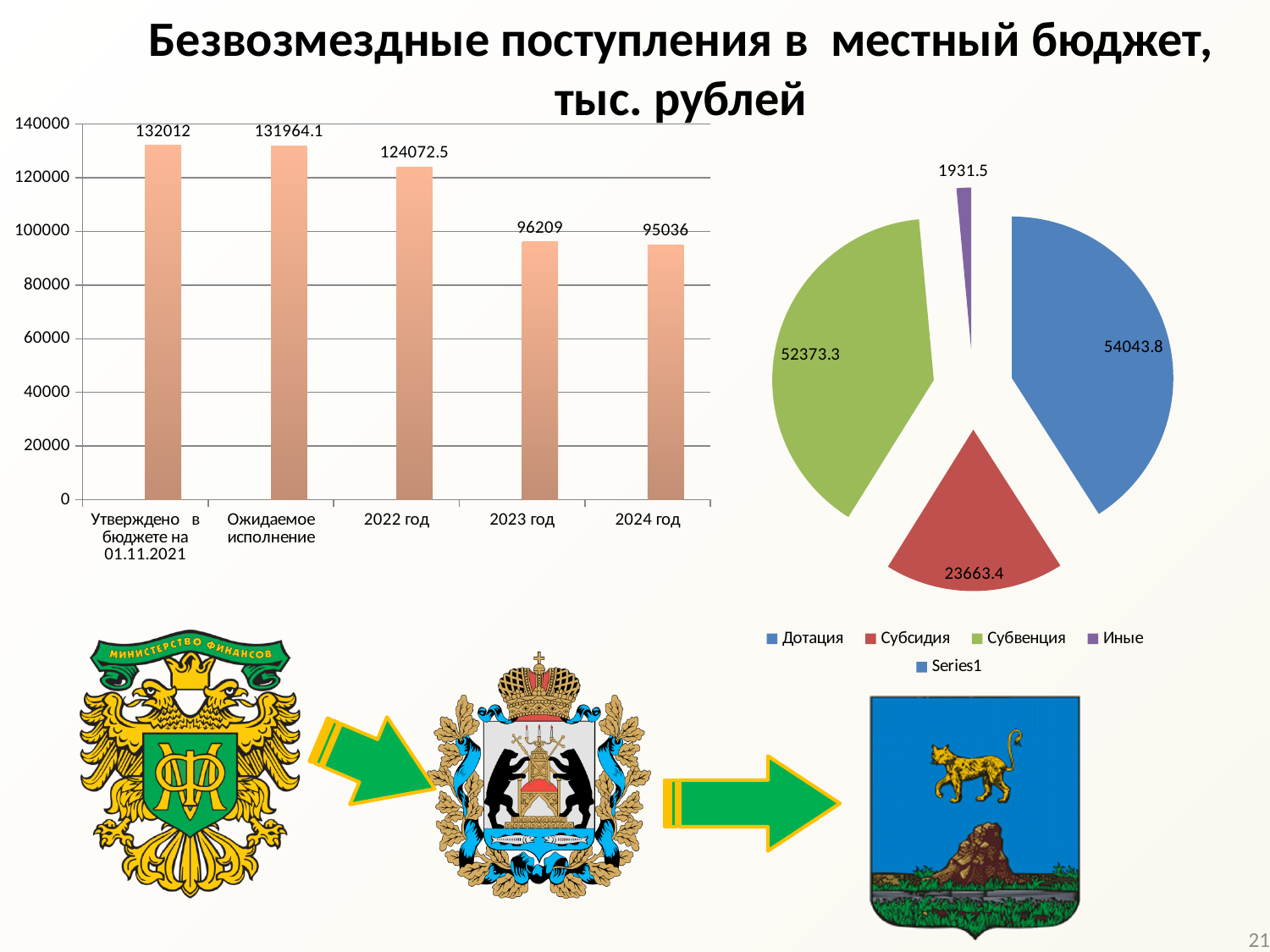
In the bar chart on the left, what is the value for Ожидаемое исполнение? 131964.1 In the pie chart on the right, which category has the smallest slice? Иные How many entries does the legend of the pie chart on the right list? 5 In the bar chart on the left, what is the value for 2022 год? 124072.5 In the bar chart on the left, do the values rise or fall from left to right along the x axis? fall In the bar chart on the left, which category has the lowest value? 2024 год In the pie chart on the right, which is larger: Субсидия or Субвенция? Субвенция In the bar chart on the left, what is the difference between the values for 2022 год and 2023 год? 27863.5 In the pie chart on the right, what is the value for Субсидия? 23663.4 How many bars are in the bar chart on the left? 5 In the bar chart on the left, which category has the highest value? Утверждено в бюджете на 01.11.2021 In the pie chart on the right, what is the difference between the values for Дотация and Субвенция? 1670.5